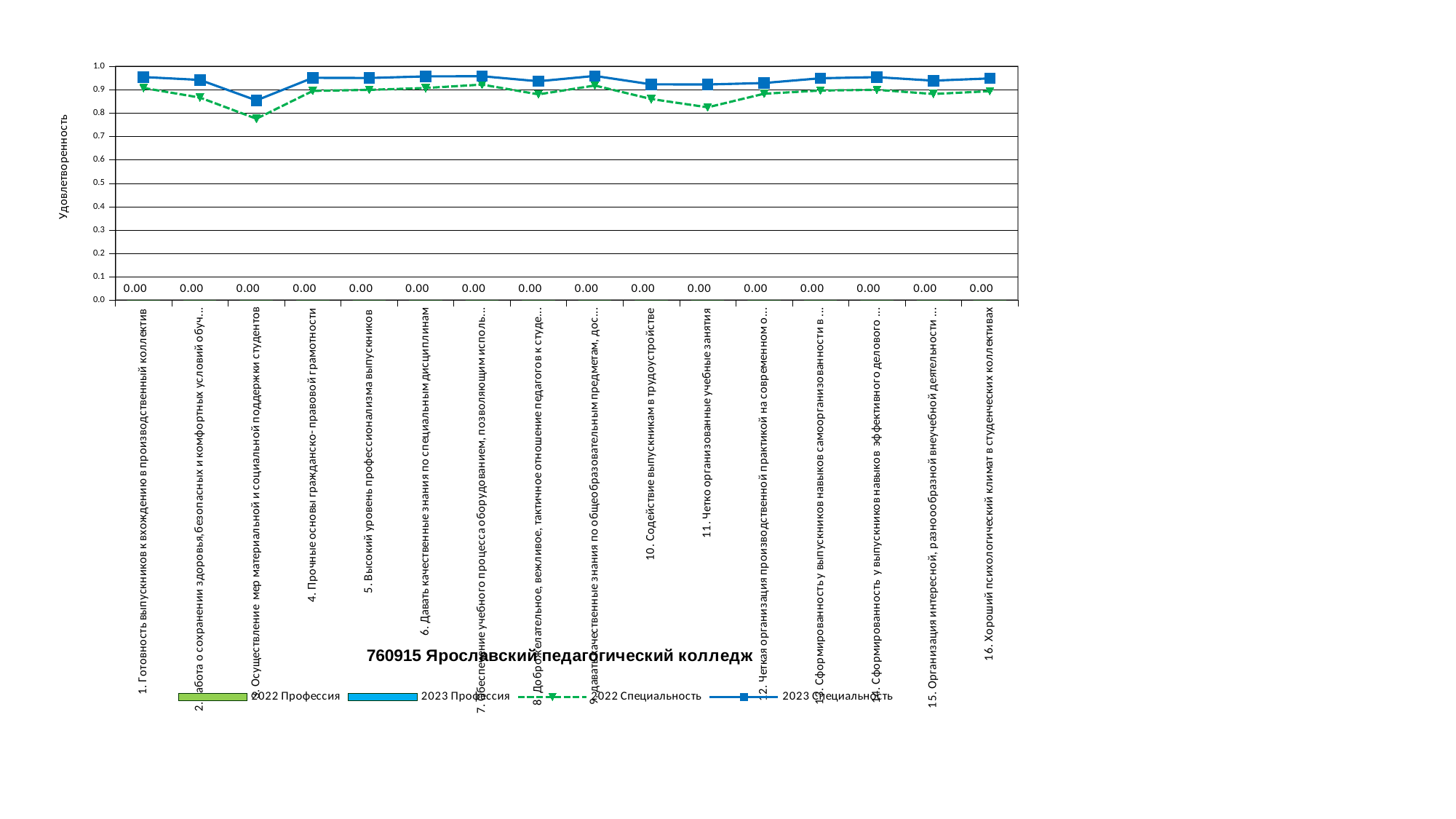
Is the 2023 Специальность value for category 1 (Готовность выпускников к вхождению в производственный коллектив) greater or less than 0.9? greater What kind of chart is used to plot the 2023 Специальность series? line chart What is the label of the vertical axis? Удовлетворенность For category 11 (Четко организованные учебные занятия), which series has the higher value: 2022 Специальность or 2023 Специальность? 2023 Специальность For which category does the 2022 Специальность series reach its lowest value? 3. Осуществление мер материальной и социальной поддержки студентов How many categories are shown along the x axis of the chart? 16 Is the 2022 Специальность value for category 3 (Осуществление мер материальной и социальной поддержки студентов) greater or less than 0.8? less What is the title of the chart? 760915 Ярославский педагогический колледж How many series does the chart legend list? 4 What value is printed as the data label at the bottom of the chart for category 16 (Хороший психологический климат в студенческих коллективах)? 0.00 For which category does the 2023 Специальность series reach its lowest value? 3. Осуществление мер материальной и социальной поддержки студентов Does the 2022 Специальность series rise or fall from category 2 to category 3? fall